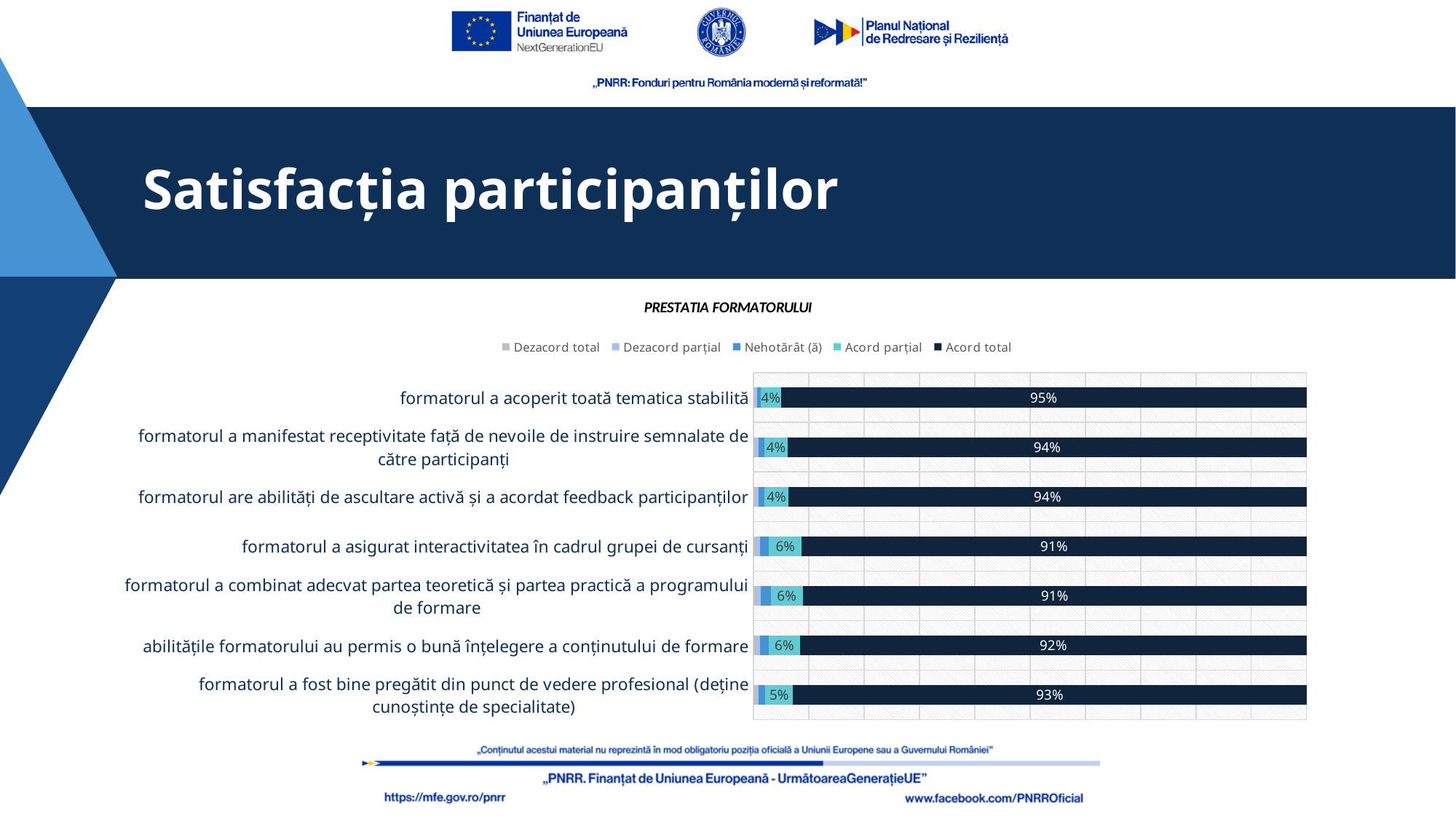
What is the Acord total value for 'formatorul a fost bine pregătit din punct de vedere profesional (deține cunoștințe de specialitate)'? 93% What is the Acord total value for 'abilitățile formatorului au permis o bună înțelegere a conținutului de formare'? 92% What is the title of the chart on the slide? PRESTATIA FORMATORULUI How many categories (statements) are plotted in the PRESTATIA FORMATORULUI chart? 7 What is the Acord total value for 'formatorul a acoperit toată tematica stabilită'? 95% How many series does the legend of the PRESTATIA FORMATORULUI chart list? 5 What type of chart is shown under the title PRESTATIA FORMATORULUI? bar chart What is the Acord parțial value for 'formatorul are abilități de ascultare activă și a acordat feedback participanților'? 4% What is the difference in Acord total between 'formatorul a acoperit toată tematica stabilită' and 'formatorul a asigurat interactivitatea în cadrul grupei de cursanți'? 4 percentage points Which statement has the highest Acord total value? formatorul a acoperit toată tematica stabilită What is the Acord parțial value for 'formatorul a asigurat interactivitatea în cadrul grupei de cursanți'? 6% Which has a larger Acord total value: 'formatorul a fost bine pregătit din punct de vedere profesional (deține cunoștințe de specialitate)' or 'formatorul a combinat adecvat partea teoretică și partea practică a programului de formare'? formatorul a fost bine pregătit din punct de vedere profesional (deține cunoștințe de specialitate)